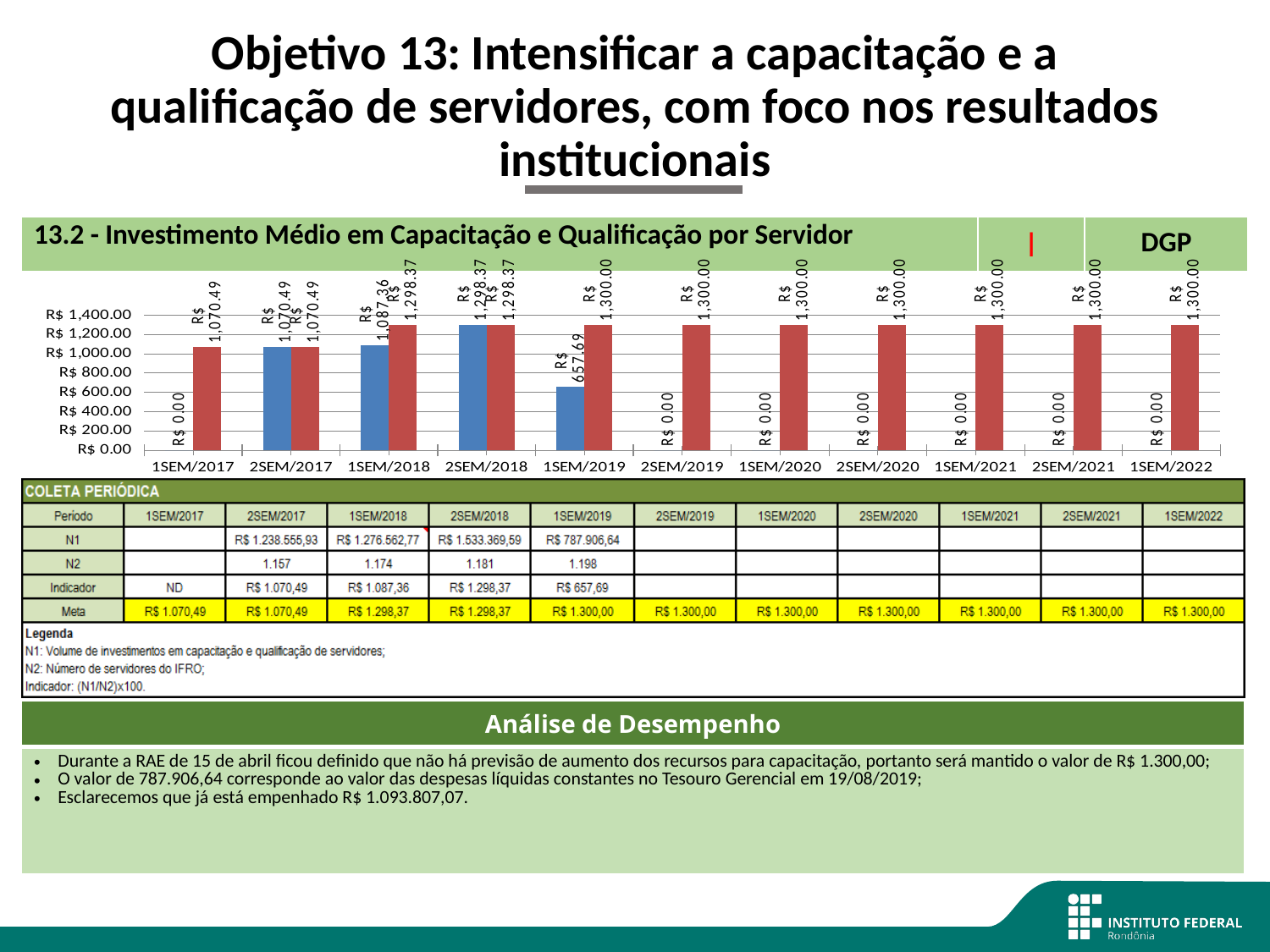
What is the value of the blue (Indicador) bar for 1SEM/2018? R$ 1,087.36 What kind of chart is shown on the slide? bar chart What is the title of the chart? 13.2 - Investimento Médio em Capacitação e Qualificação por Servidor How many periods (categories) are shown on the x axis of the chart? 11 What is the value of the red (Meta) bar for 1SEM/2019? R$ 1,300.00 What is the difference between the red (Meta) bar and the blue (Indicador) bar for 1SEM/2019? R$ 642.31 Which period has the highest blue (Indicador) bar? 2SEM/2018 Do the red (Meta) bars rise or fall from 1SEM/2017 to 1SEM/2019? rise What is the value of the red (Meta) bar for 1SEM/2017? R$ 1,070.49 What is the value of the blue (Indicador) bar for 1SEM/2019? R$ 657.69 Among the periods with a non-zero blue (Indicador) bar, which has the lowest value? 1SEM/2019 For 1SEM/2018, which is larger: the blue (Indicador) bar or the red (Meta) bar? the red (Meta) bar